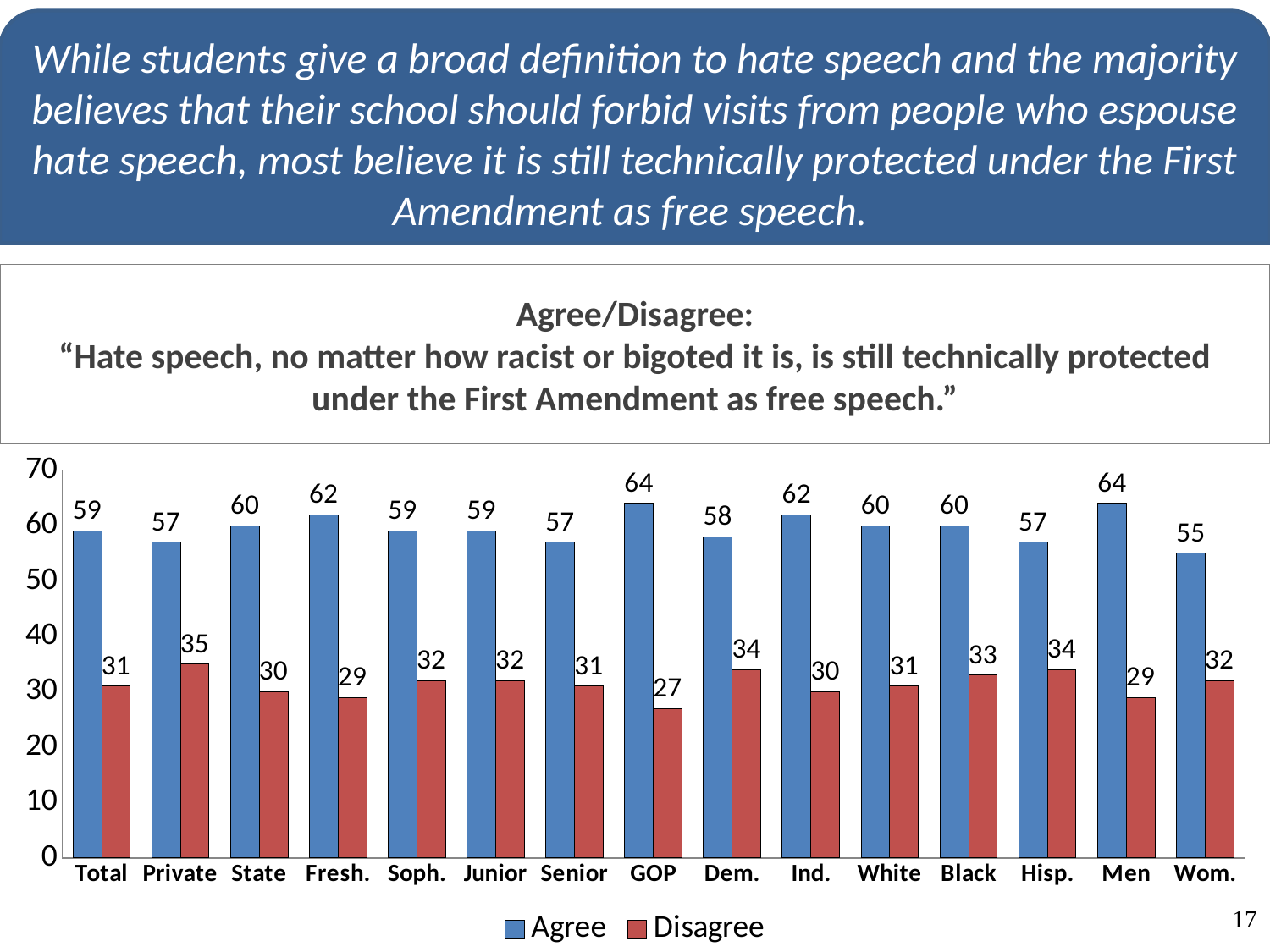
What is the Disagree value for GOP? 27 What kind of chart is shown on the slide? Bar chart How many series does the legend list? 2 Which series is shown in red in the legend? Disagree How many categories are shown on the x axis? 15 What is the Agree value for Wom.? 55 What is the difference between the Agree and Disagree values for Men? 35 Which category has the highest Disagree value? Private What is the Agree value for Total? 59 What is the difference between the Disagree values for Private and GOP? 8 Which category has the lowest Agree value? Wom. Which is larger, the Agree value for Private or the Agree value for State? State